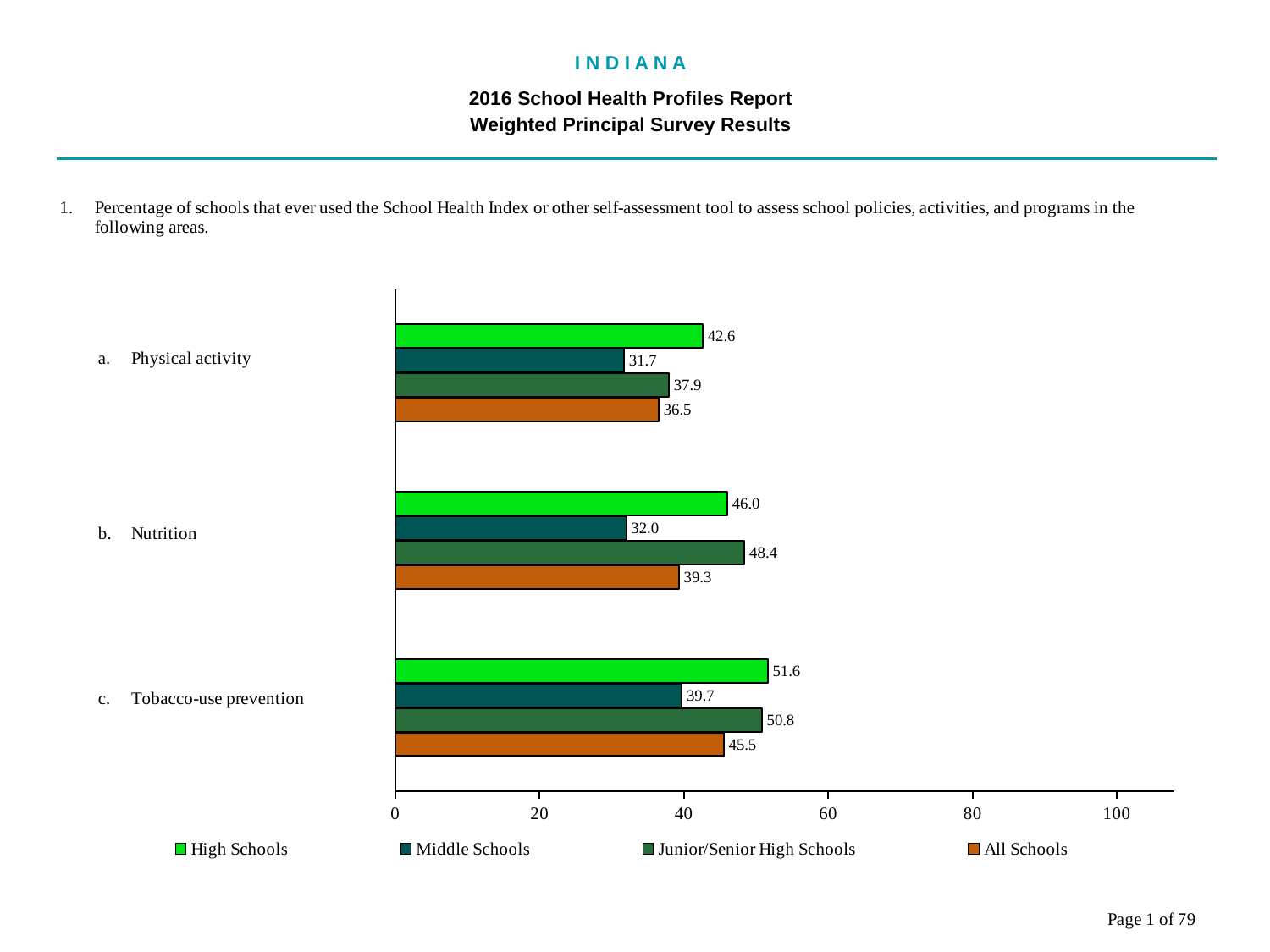
Which series is shown in orange in the legend? All Schools What is the value for Middle Schools in the Nutrition category? 32.0 What is the difference between the High Schools and Middle Schools values in the Tobacco-use prevention category? 11.9 Which category has the lowest value for Middle Schools? Physical activity What kind of chart is shown on the slide? Bar chart Which is larger in the Nutrition category: the High Schools value or the Junior/Senior High Schools value? Junior/Senior High Schools What is the value for All Schools in the Tobacco-use prevention category? 45.5 What is the value for Junior/Senior High Schools in the Nutrition category? 48.4 What is the value for High Schools in the Physical activity category? 42.6 How many categories are shown on the chart? 3 How many series does the legend list? 4 Which category has the highest value for High Schools? Tobacco-use prevention